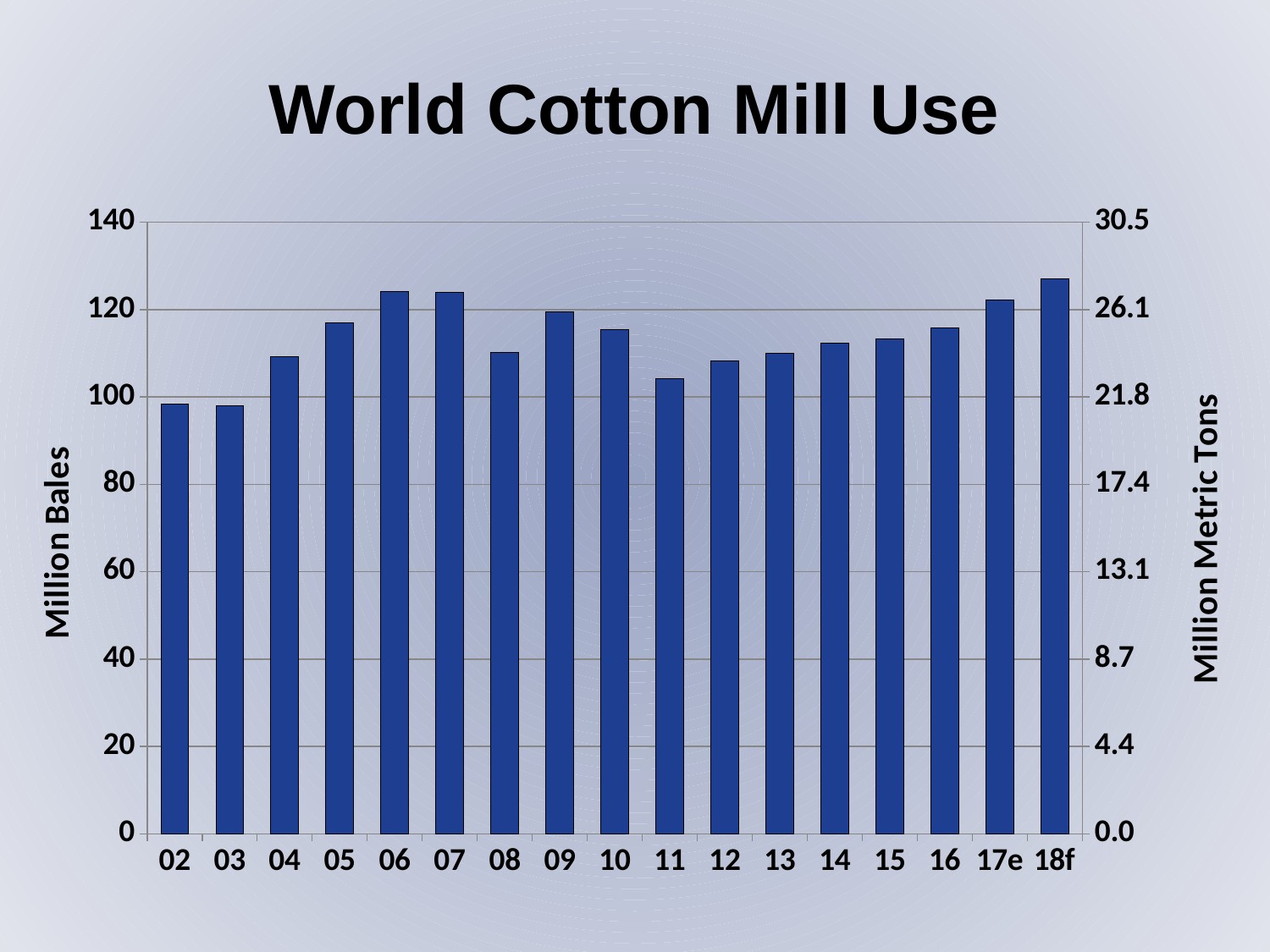
What is the label of the left vertical axis? Million Bales Do the values rise or fall from 11 to 18f? rise What type of chart is shown on the slide? bar chart Which is larger, the value for 04 or the value for 06? 06 How many years (bars) are shown on the x axis? 17 What is the title of the chart? World Cotton Mill Use Which year has the highest cotton mill use? 18f Is the value for 18f greater or less than 120 million bales? greater Is the value for 08 greater or less than 120 million bales? less Is the value for 02 greater or less than 100 million bales? less Which is larger, the value for 09 or the value for 11? 09